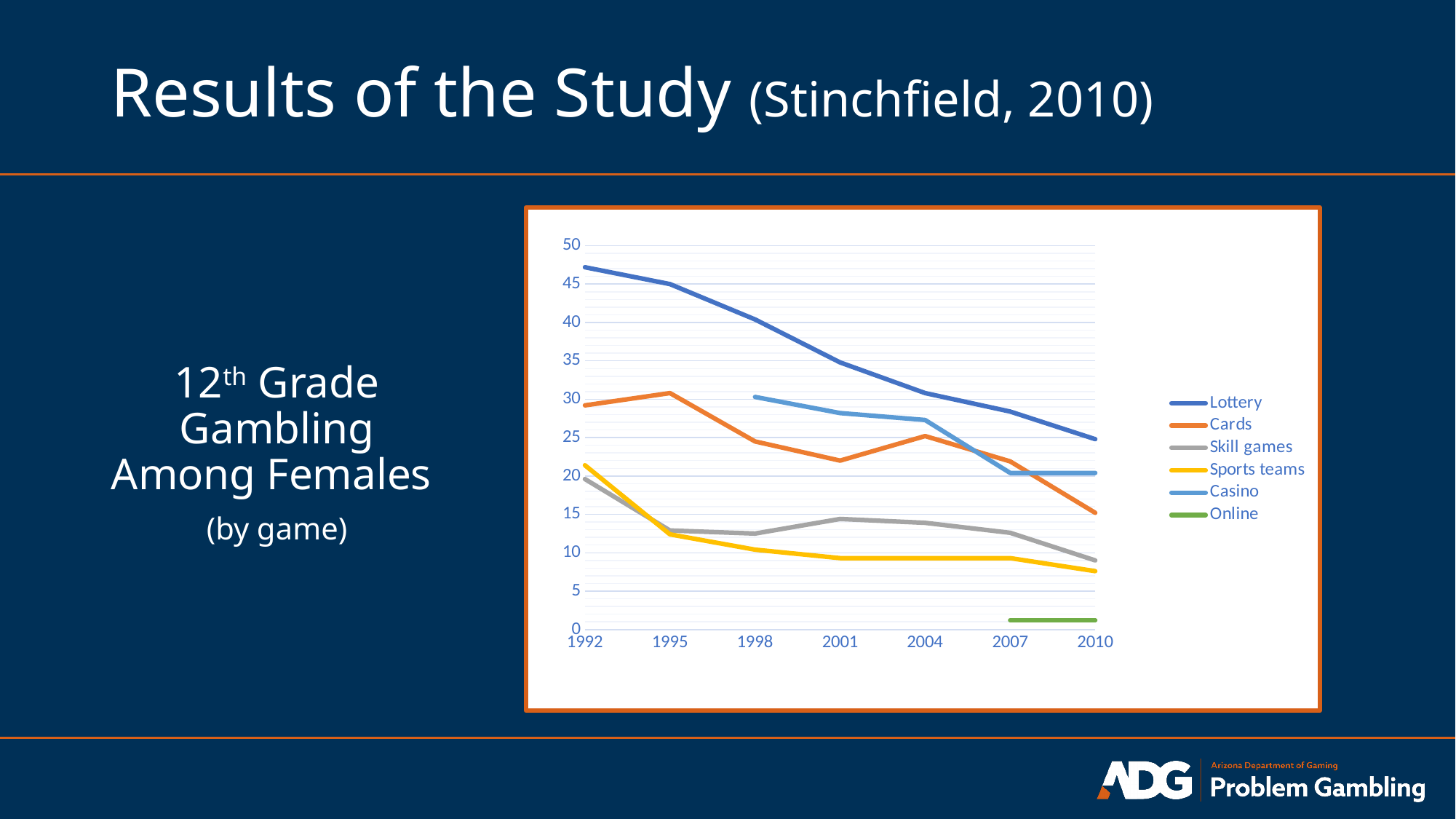
Is the value for Sports teams in 2010 greater or less than 10? less How many series does the chart's legend list? 6 Is the value for Online in 2007 greater or less than 5? less What kind of chart is shown on the slide? line chart Is the value for Lottery in 1992 greater or less than 45? greater Does the Lottery line rise or fall from 1992 to 2010? fall Which is larger in 2004, Skill games or Sports teams? Skill games What is the subtitle describing the chart on the left of the slide? 12th Grade Gambling Among Females (by game) Which series has the highest value in 1992? Lottery Which series has the lowest value in 2010? Online How many years are shown on the x axis of the chart? 7